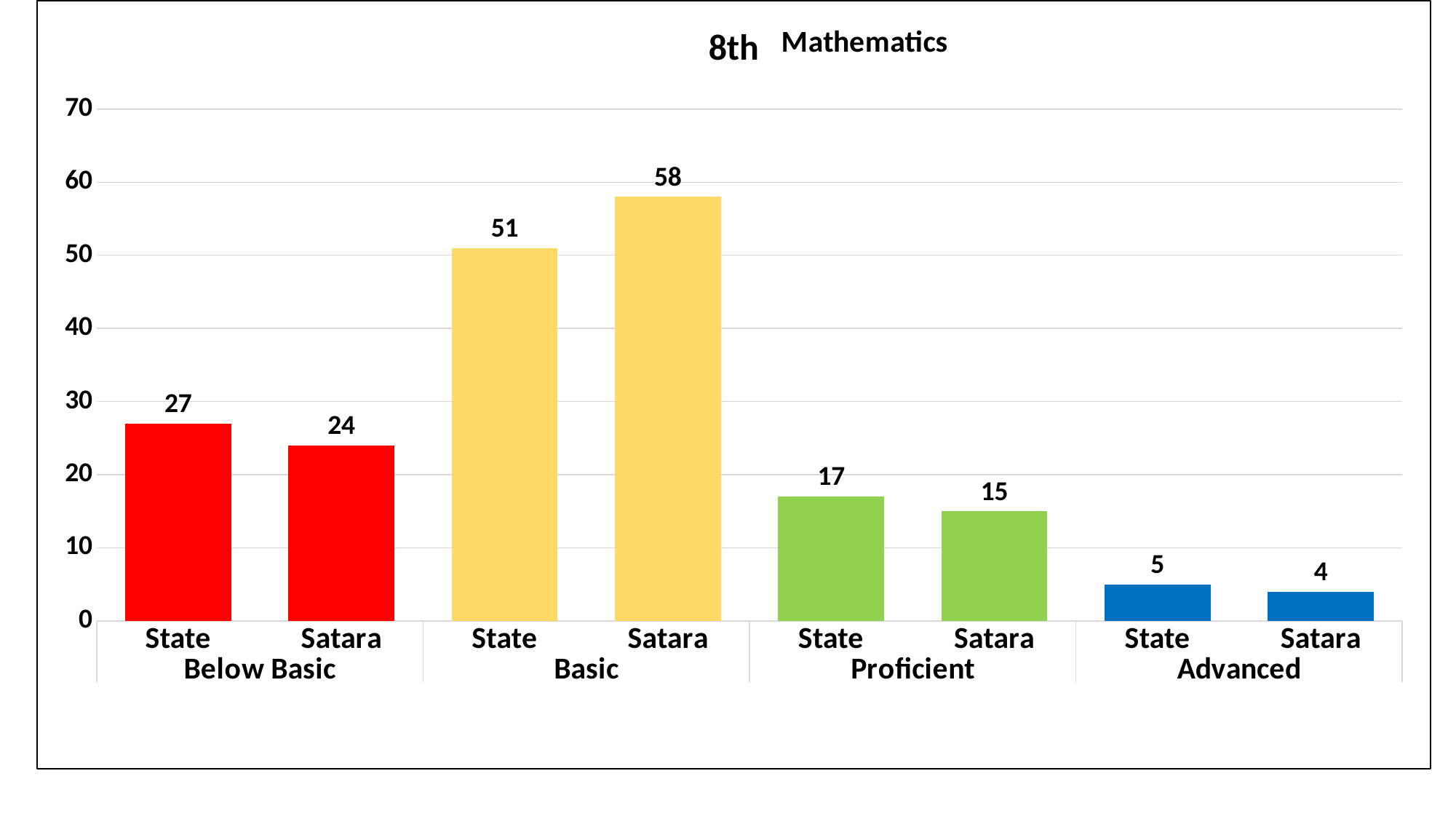
Which bar has the lowest value on the chart? Satara, Advanced What is the value for Satara in the Basic category? 58 What is the title of the chart? 8th Mathematics What is the value for State in the Proficient category? 17 Which is larger in the Proficient category, State or Satara? State What kind of chart is shown on the slide? Bar chart What is the value for Satara in the Advanced category? 4 What is the value for State in the Below Basic category? 27 Which bar has the highest value on the chart? Satara, Basic What is the difference between the State and Satara values in the Below Basic category? 3 How many performance level categories are shown on the x axis? 4 What is the difference between the Satara and State values in the Basic category? 7